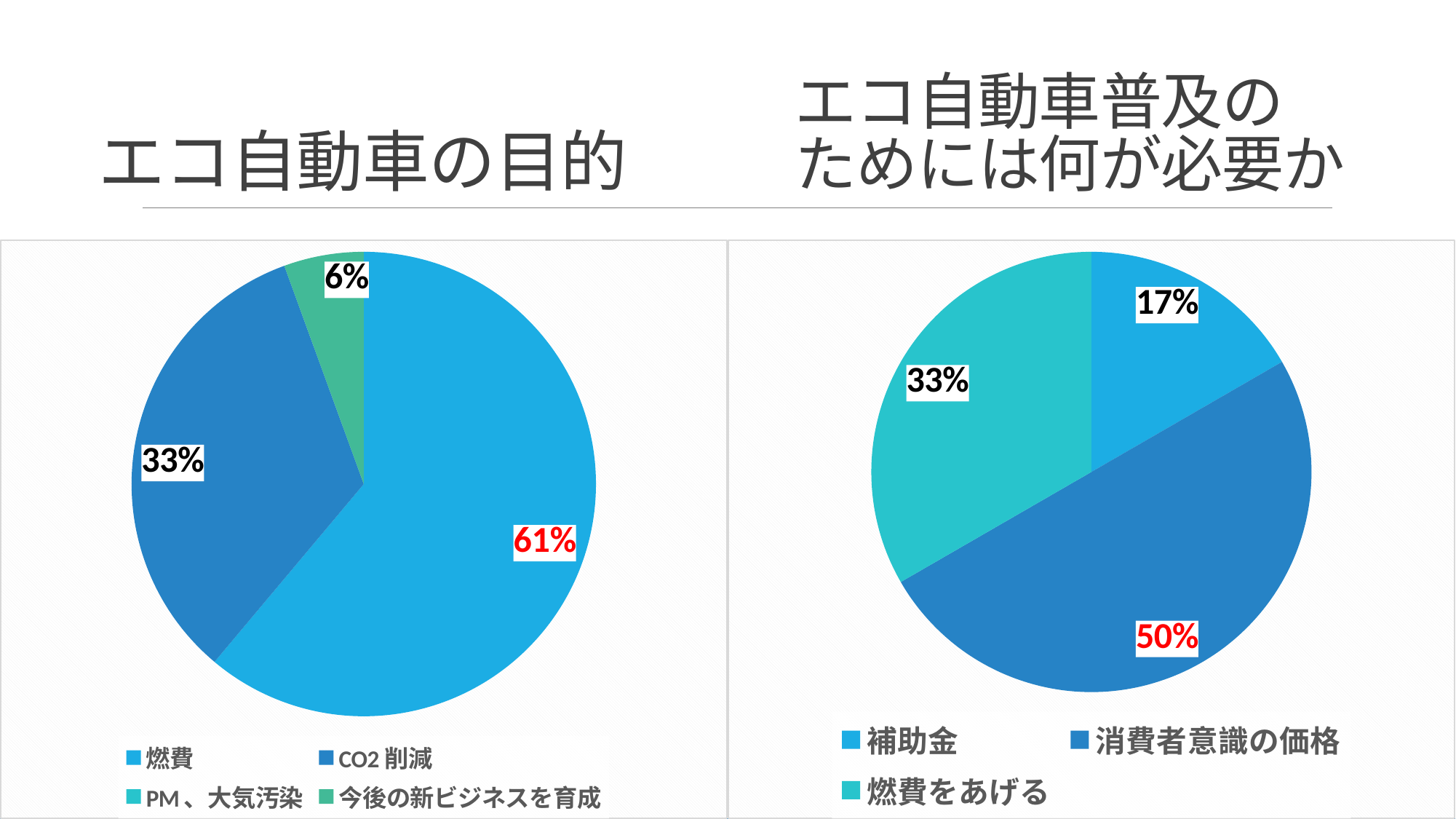
In the right chart (エコ自動車普及のためには何が必要か), how many slices does the pie have? 3 In the left chart (エコ自動車の目的), which category has the largest slice? 燃費 In the right chart (エコ自動車普及のためには何が必要か), what percentage is shown for 補助金? 17% In the left chart (エコ自動車の目的), what percentage is shown for 燃費? 61% In the right chart (エコ自動車普及のためには何が必要か), which category has the smallest slice? 補助金 In the left chart (エコ自動車の目的), what percentage is shown for CO2 削減? 33% What type of chart is the right chart (エコ自動車普及のためには何が必要か)? Pie chart In the left chart (エコ自動車の目的), what percentage is shown for 今後の新ビジネスを育成? 6% In the left chart (エコ自動車の目的), what is the difference between the 燃費 slice and the CO2 削減 slice? 28% In the right chart (エコ自動車普及のためには何が必要か), what percentage is shown for 燃費をあげる? 33% In the left chart (エコ自動車の目的), how many entries does the legend list? 4 In the right chart (エコ自動車普及のためには何が必要か), what percentage is shown for 消費者意識の価格? 50%